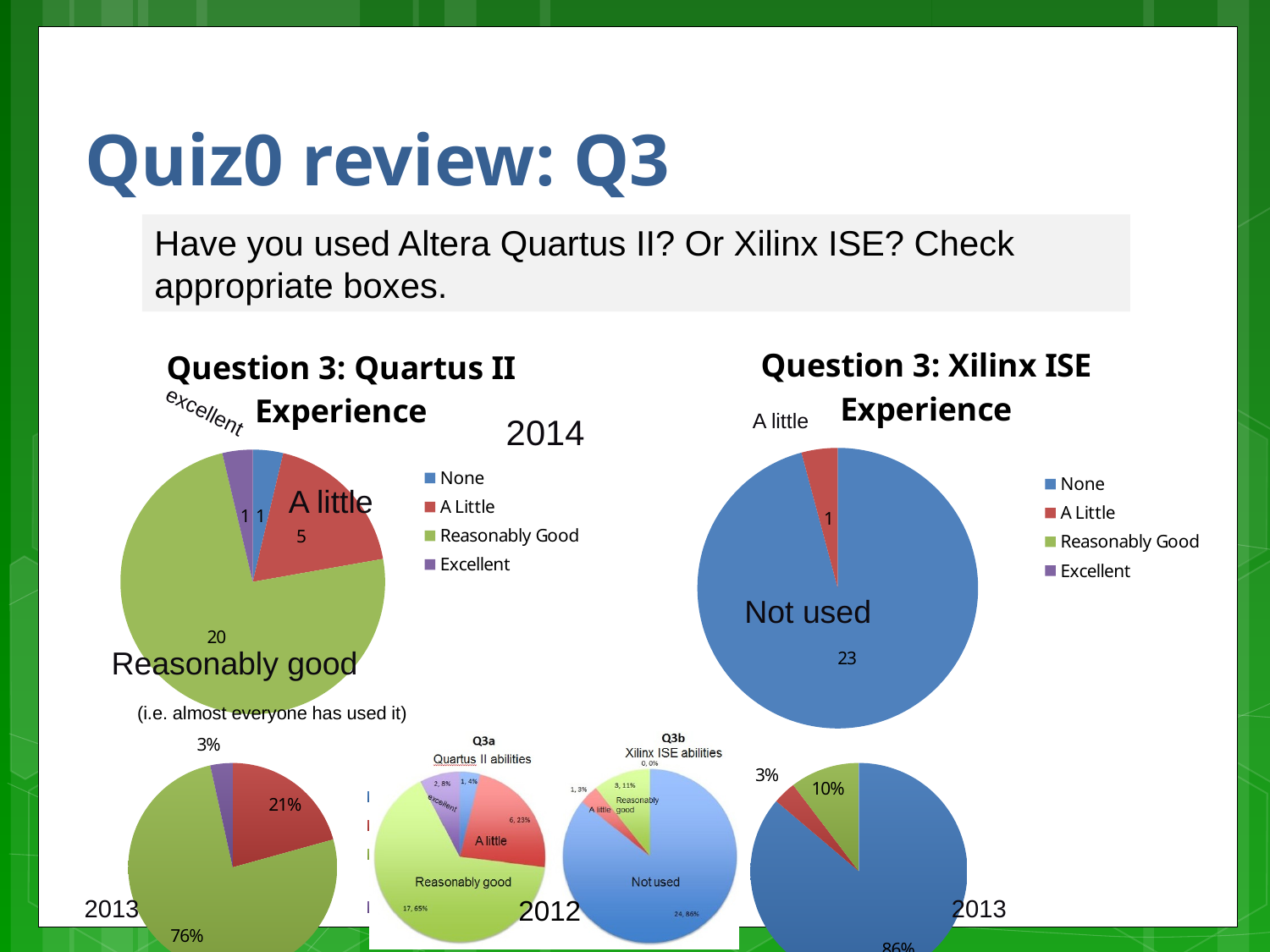
On the 'Question 3: Quartus II Experience' pie chart, what value is shown for the A Little slice? 5 On the 'Question 3: Xilinx ISE Experience' pie chart, what is the difference between the Not used value and the A little value? 22 On the 2013 Quartus II pie chart at the bottom left, what percentage is shown for the largest (green) slice? 76% On the 'Question 3: Quartus II Experience' pie chart, what is the difference between the Reasonably Good value and the A Little value? 15 On the 'Question 3: Xilinx ISE Experience' pie chart, what value is shown for the Not used slice? 23 What kind of chart is 'Question 3: Xilinx ISE Experience'? Pie chart On the 'Question 3: Xilinx ISE Experience' pie chart, what value is shown for the A little slice? 1 On the 'Question 3: Quartus II Experience' pie chart, what value is shown for the Reasonably Good slice? 20 On the 'Question 3: Quartus II Experience' pie chart, which category has the largest slice? Reasonably Good On the 'Question 3: Xilinx ISE Experience' pie chart, which is larger, the Not used slice or the A little slice? Not used On the 2013 Xilinx ISE pie chart at the bottom right, what percentage is shown for the green slice? 10% How many entries does the legend of the 'Question 3: Quartus II Experience' chart list? 4